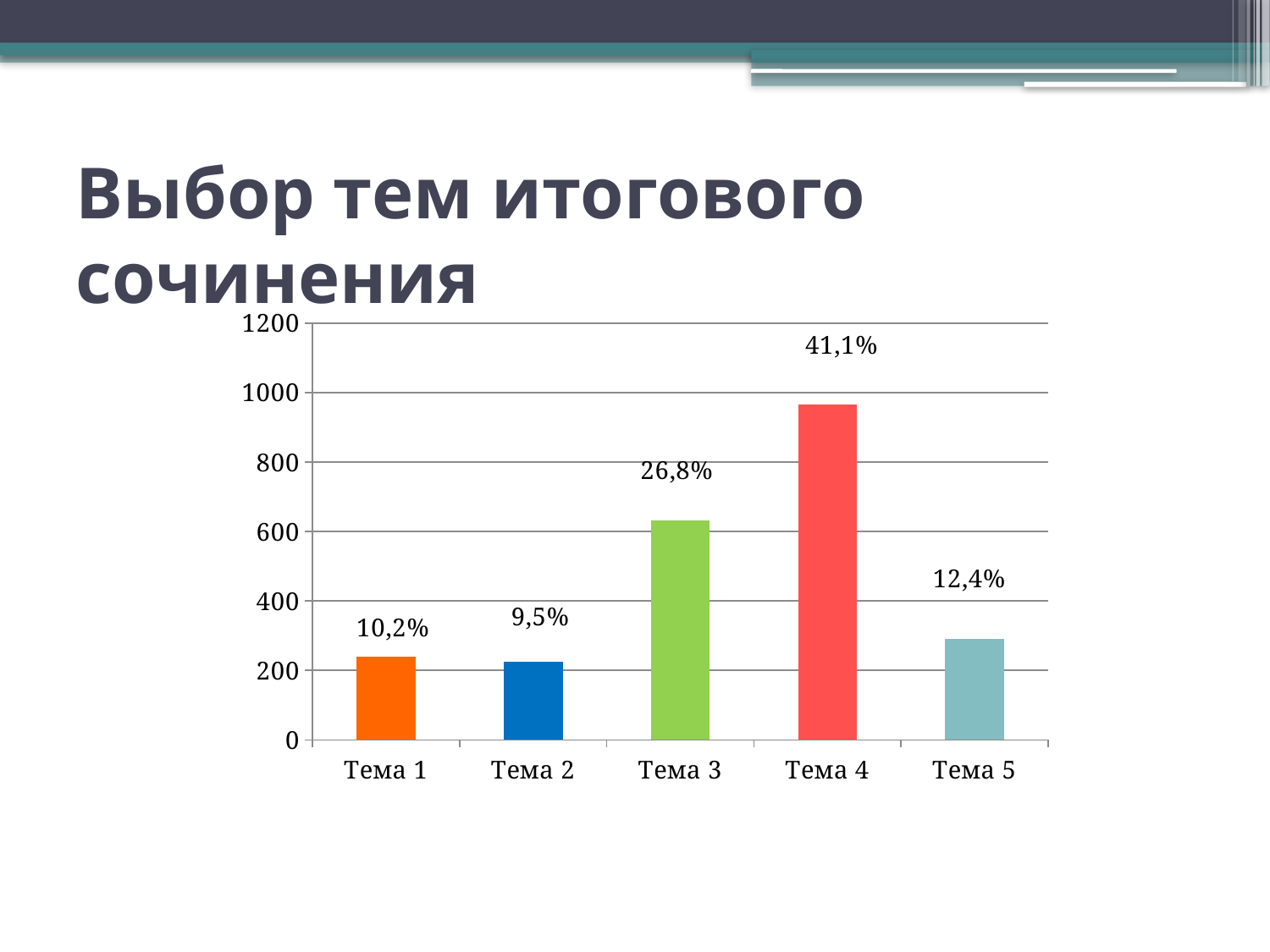
What percentage label is shown above the bar for Тема 5? 12,4% What percentage label is shown above the bar for Тема 4? 41,1% Is the value for Тема 5 greater or less than 400? less What percentage label is shown above the bar for Тема 2? 9,5% Which bar is taller, Тема 3 or Тема 5? Тема 3 How many categories are shown on the x axis? 5 What percentage label is shown above the bar for Тема 3? 26,8% What is the title of the slide containing the chart? Выбор тем итогового сочинения Is the value for Тема 4 greater or less than 800? greater Which category has the highest bar? Тема 4 What kind of chart is shown on the slide? bar chart Which category has the lowest bar? Тема 2